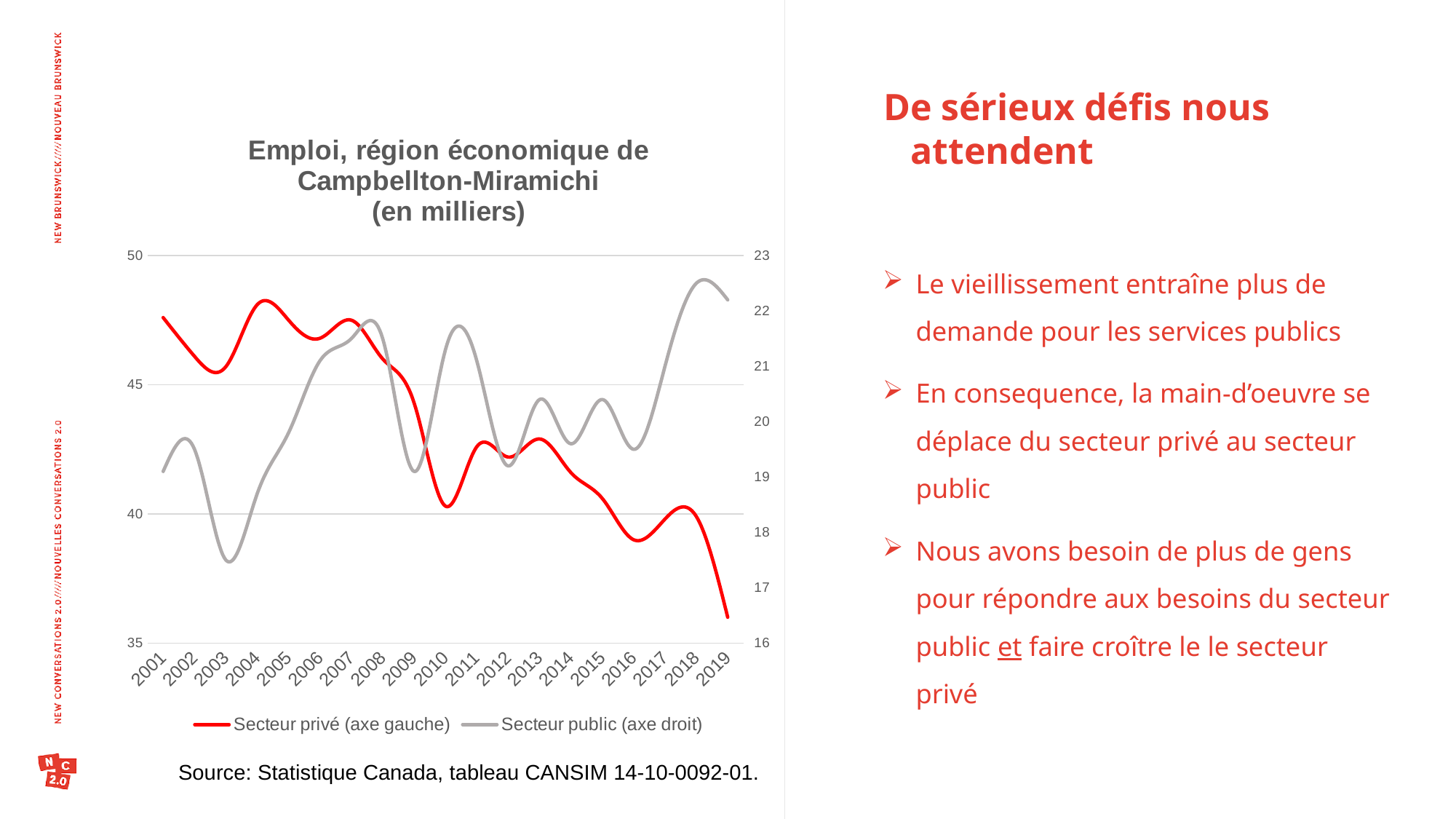
In which year is the Secteur privé value lowest? 2019 Which series is drawn in red? Secteur privé (axe gauche) In which year is the Secteur public value highest? 2018 Is the Secteur privé value for 2001 greater or less than 45? greater Does the Secteur privé series rise or fall overall from 2001 to 2019? fall What kind of chart is shown on the slide? line chart How many years are plotted along the x axis? 19 Is the Secteur public value for 2018 greater or less than 22? greater What is the title of the chart? Emploi, région économique de Campbellton-Miramichi (en milliers) How many series does the legend list? 2 Is the Secteur privé value for 2019 greater or less than 40? less In which year is the Secteur public value lowest? 2003